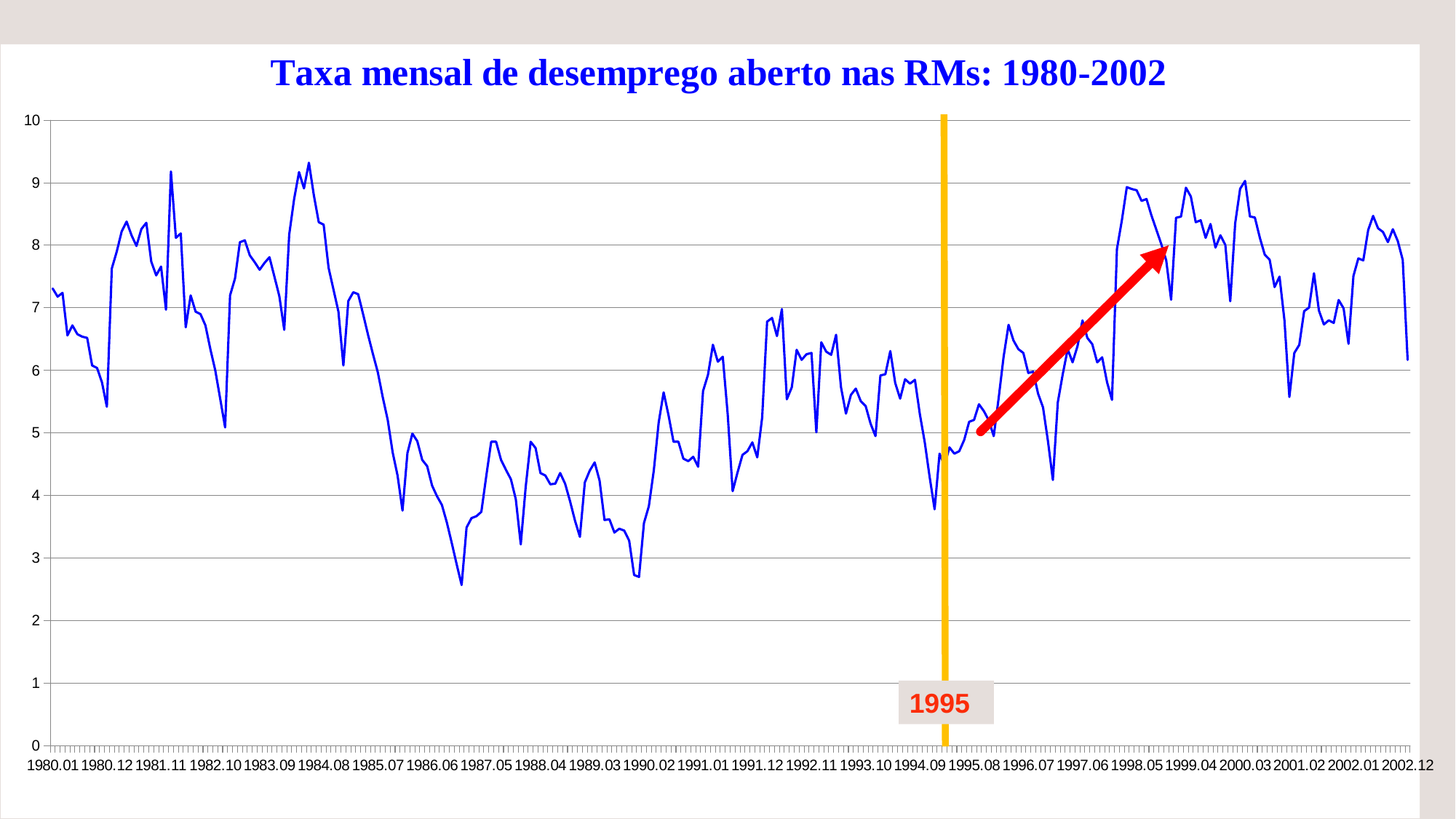
Does the line generally rise or fall between 1995 and 1999, as indicated by the red arrow? rise What is the title of the chart? Taxa mensal de desemprego aberto nas RMs: 1980-2002 Is the value at 1999.04 greater or less than 8? greater Is the value at 1995.08 greater or less than 6? less Is the value at 1980.01 greater or less than 6? greater What is the maximum value shown on the vertical axis? 10 What year is labelled on the vertical orange line in the chart? 1995 Does the line generally rise or fall between 1984.08 and 1986.06? fall What kind of chart is shown on the slide? line chart